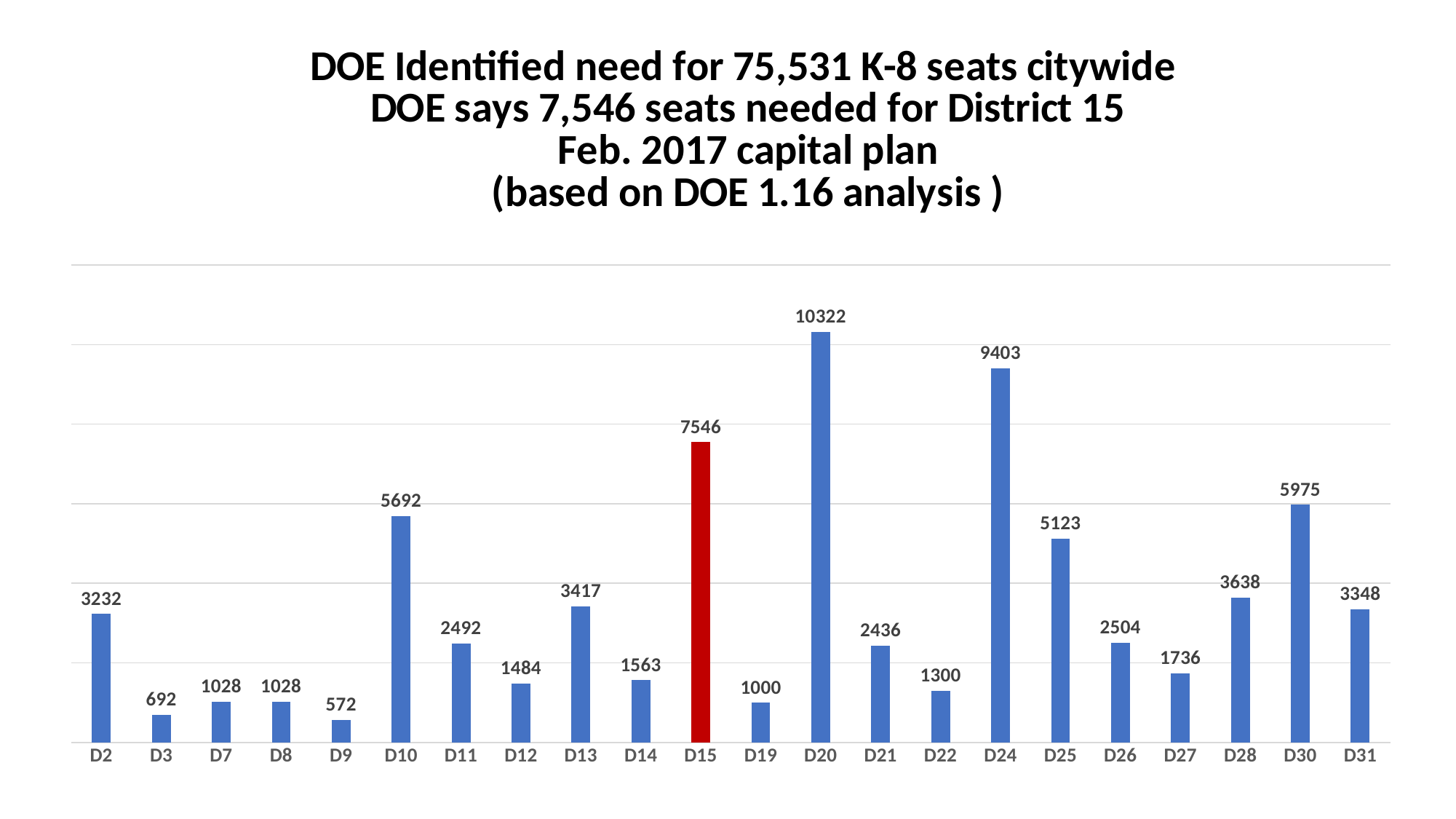
Which district has the highest value? D20 What is the value for D28? 3638 What kind of chart is shown on the slide? bar chart Which bar is coloured red instead of blue? D15 Which is larger, the value for D25 or the value for D30? D30 How many districts are shown on the x axis? 22 What is the value for D9? 572 What is the value for D15? 7546 Which district has the lowest value? D9 What is the difference between the values for D15 and D10? 1854 What is the difference between the values for D20 and D24? 919 What is the value for D20? 10322